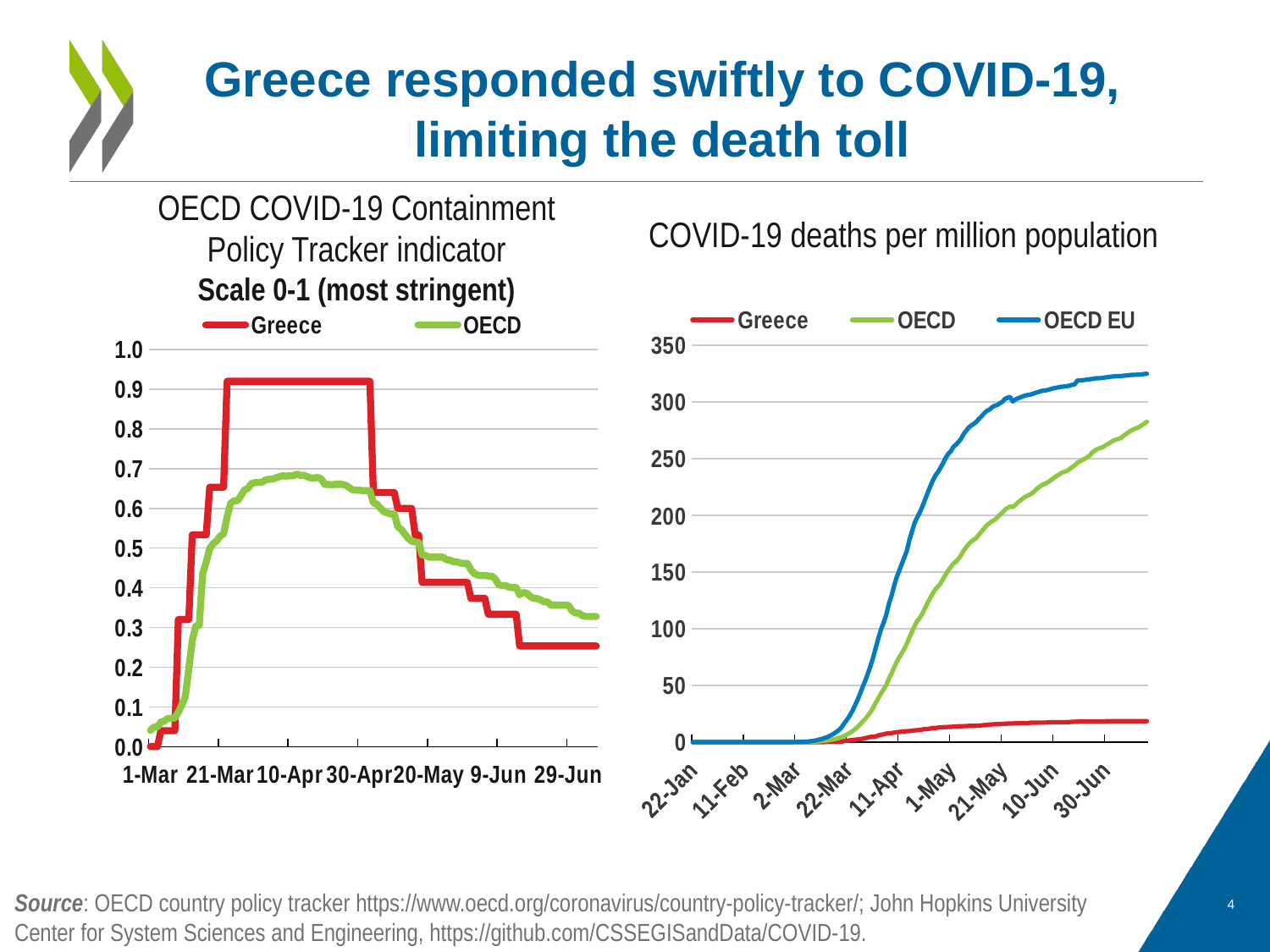
In the 'COVID-19 deaths per million population' chart, is the value for Greece at 30-Jun greater or less than 50? less What type of chart is the 'COVID-19 deaths per million population' chart? line chart How many series does the legend of the 'OECD COVID-19 Containment Policy Tracker indicator' chart list? 2 In the 'OECD COVID-19 Containment Policy Tracker indicator' chart, is the peak value for Greece greater or less than 0.8? greater How many series does the legend of the 'COVID-19 deaths per million population' chart list? 3 In the 'COVID-19 deaths per million population' chart, do the values for OECD EU rise or fall from 22-Mar to 30-Jun? rise In the 'COVID-19 deaths per million population' chart, is the value for OECD at 30-Jun greater or less than 300? less In the 'COVID-19 deaths per million population' chart, which series is highest at the end of the period (30-Jun)? OECD EU In the 'OECD COVID-19 Containment Policy Tracker indicator' chart, which series is higher at 29-Jun, Greece or OECD? OECD In the 'COVID-19 deaths per million population' chart, which series is lowest at the end of the period? Greece In the 'OECD COVID-19 Containment Policy Tracker indicator' chart, which series is higher around 10-Apr, Greece or OECD? Greece